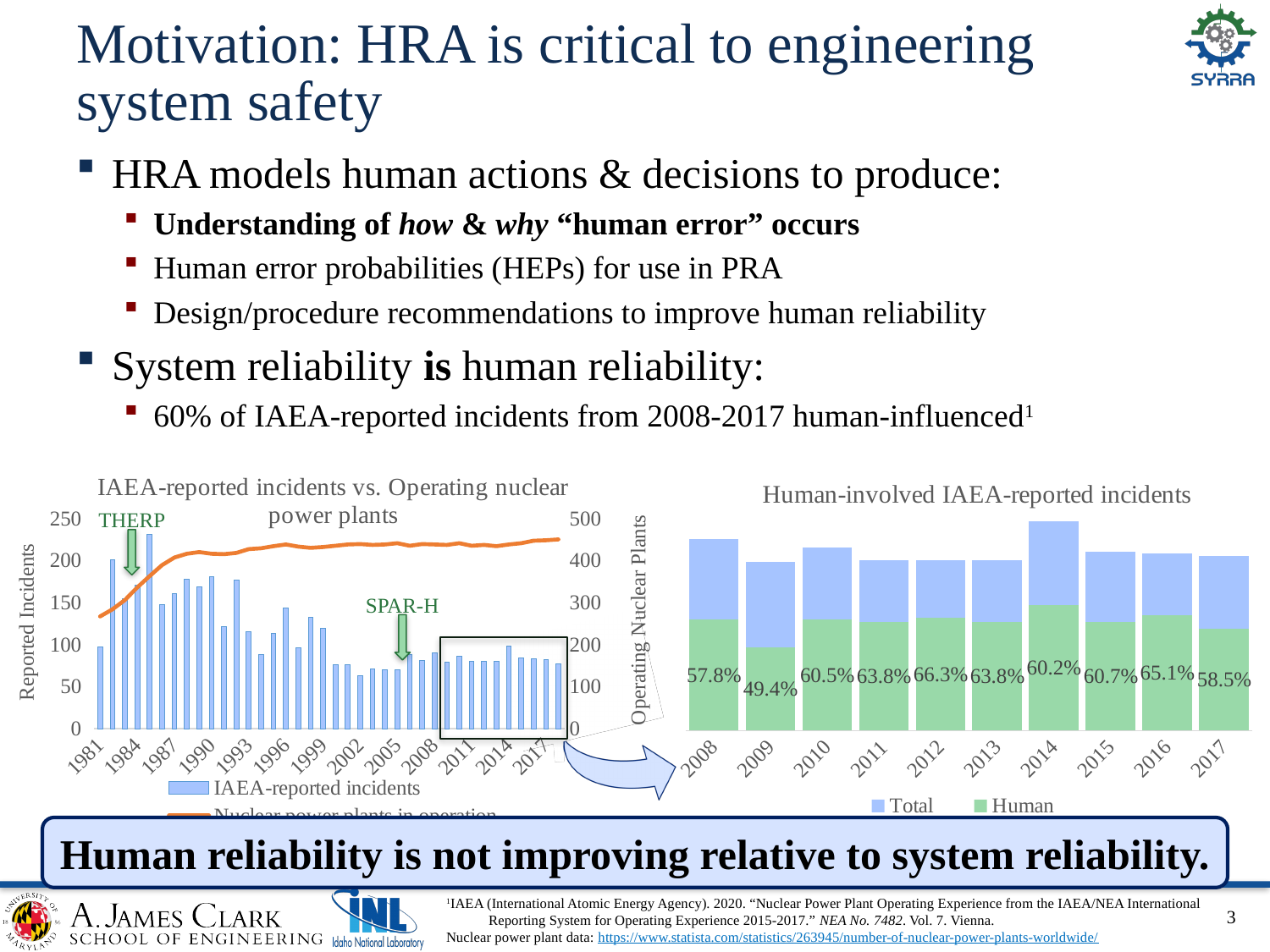
In the 'Human-involved IAEA-reported incidents' chart, which year has the highest human-involved percentage? 2012 In the 'IAEA-reported incidents vs. Operating nuclear power plants' chart, what does the orange line represent? Nuclear power plants in operation In the 'Human-involved IAEA-reported incidents' chart, what percentage is shown for 2017? 58.5% In the 'Human-involved IAEA-reported incidents' chart, which year has the lowest human-involved percentage? 2009 In the 'Human-involved IAEA-reported incidents' chart, what is the difference in percentage points between 2012 and 2009? 16.9 percentage points In the 'Human-involved IAEA-reported incidents' chart, what percentage is shown for 2012? 66.3% What kind of chart is the 'Human-involved IAEA-reported incidents' chart? Bar chart How many series does the legend of the 'Human-involved IAEA-reported incidents' chart list? 2 In the 'IAEA-reported incidents vs. Operating nuclear power plants' chart, is the number of IAEA-reported incidents for 2017 greater or less than 100? less How many years are shown in the 'Human-involved IAEA-reported incidents' chart? 10 In the 'Human-involved IAEA-reported incidents' chart, which year has the larger percentage, 2016 or 2017? 2016 In the 'Human-involved IAEA-reported incidents' chart, what percentage is shown for 2009? 49.4%